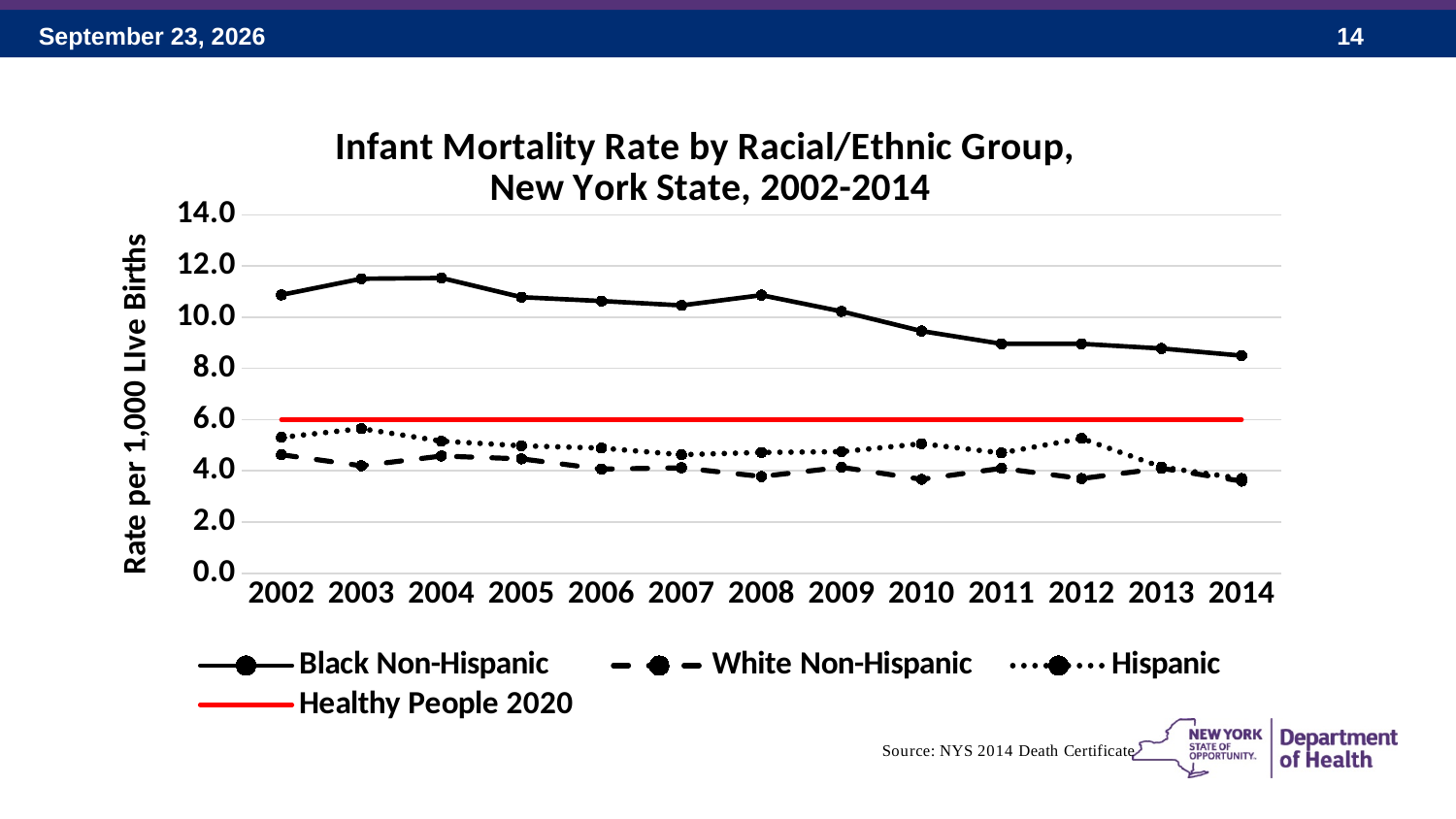
Is the Black Non-Hispanic rate in 2014 greater or less than 10.0? less What kind of chart is shown on the slide? line chart In which year is the Black Non-Hispanic rate lowest? 2014 Is the Black Non-Hispanic rate in 2004 greater or less than 10.0? greater Does the Black Non-Hispanic infant mortality rate rise or fall from 2002 to 2014 overall? fall In 2008, which is larger: the Black Non-Hispanic rate or the White Non-Hispanic rate? Black Non-Hispanic How many series does the legend list? 4 How many years are shown along the x axis? 13 Which racial/ethnic group has the highest infant mortality rate in 2014? Black Non-Hispanic What is the value of the Healthy People 2020 line? 6.0 What is the y-axis label of the chart? Rate per 1,000 Live Births Is the White Non-Hispanic rate in 2002 greater or less than 6.0? less